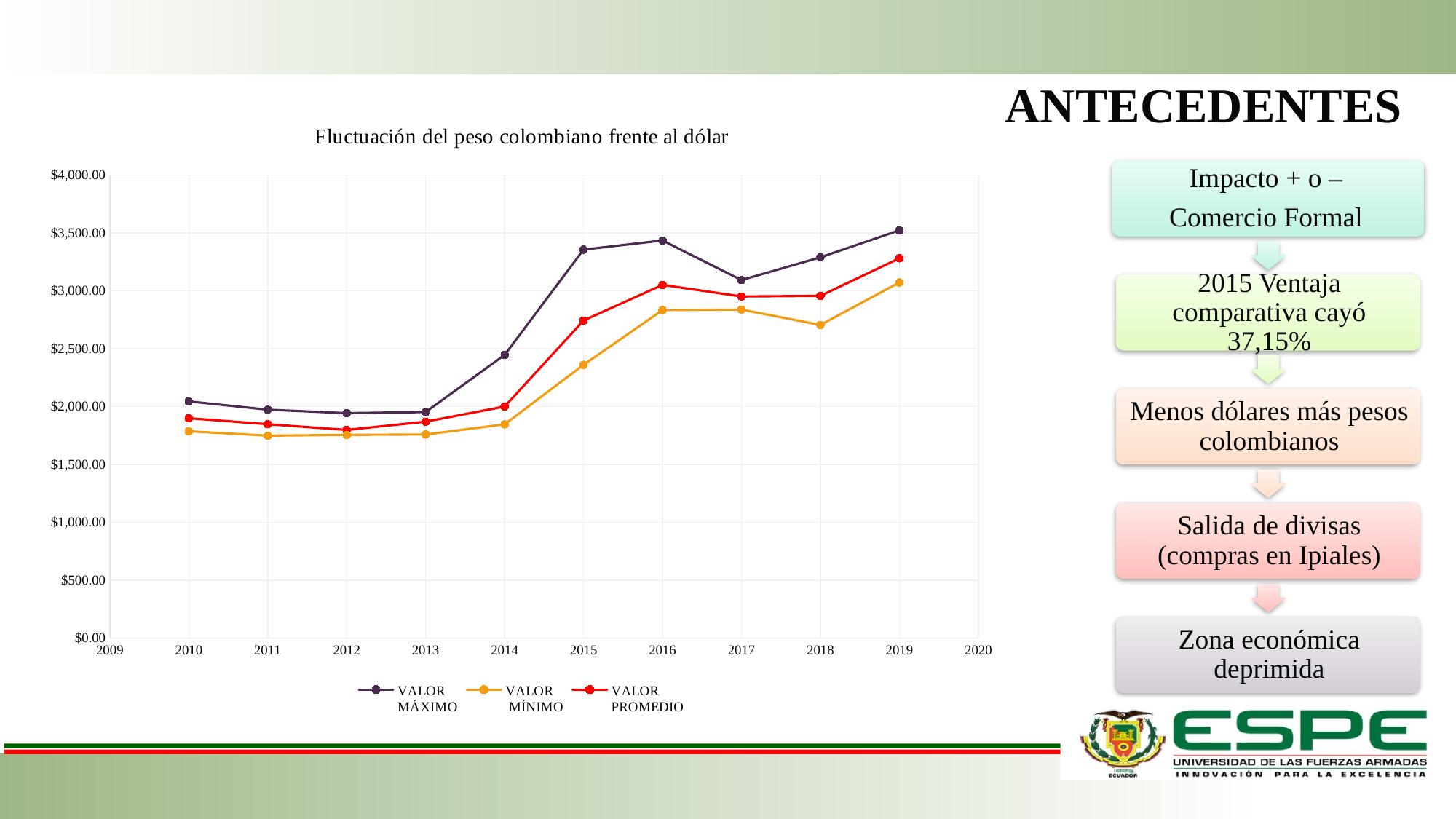
In which year is the VALOR MÁXIMO series at its highest? 2019 What is the title of the chart? Fluctuación del peso colombiano frente al dólar Does the VALOR MÁXIMO series rise or fall between 2013 and 2016? Rise What kind of chart is shown on the slide? Line chart Is the VALOR MÍNIMO value for 2015 greater or less than $2,500.00? less Is the VALOR MÁXIMO value for 2015 greater or less than $3,000.00? greater Which year has the larger VALOR MÁXIMO value, 2016 or 2017? 2016 Is the VALOR PROMEDIO value for 2010 greater or less than $2,000.00? less In which year is the VALOR PROMEDIO series at its highest? 2019 How many series does the chart legend list? 3 How many years have data points plotted for the VALOR MÁXIMO series? 10